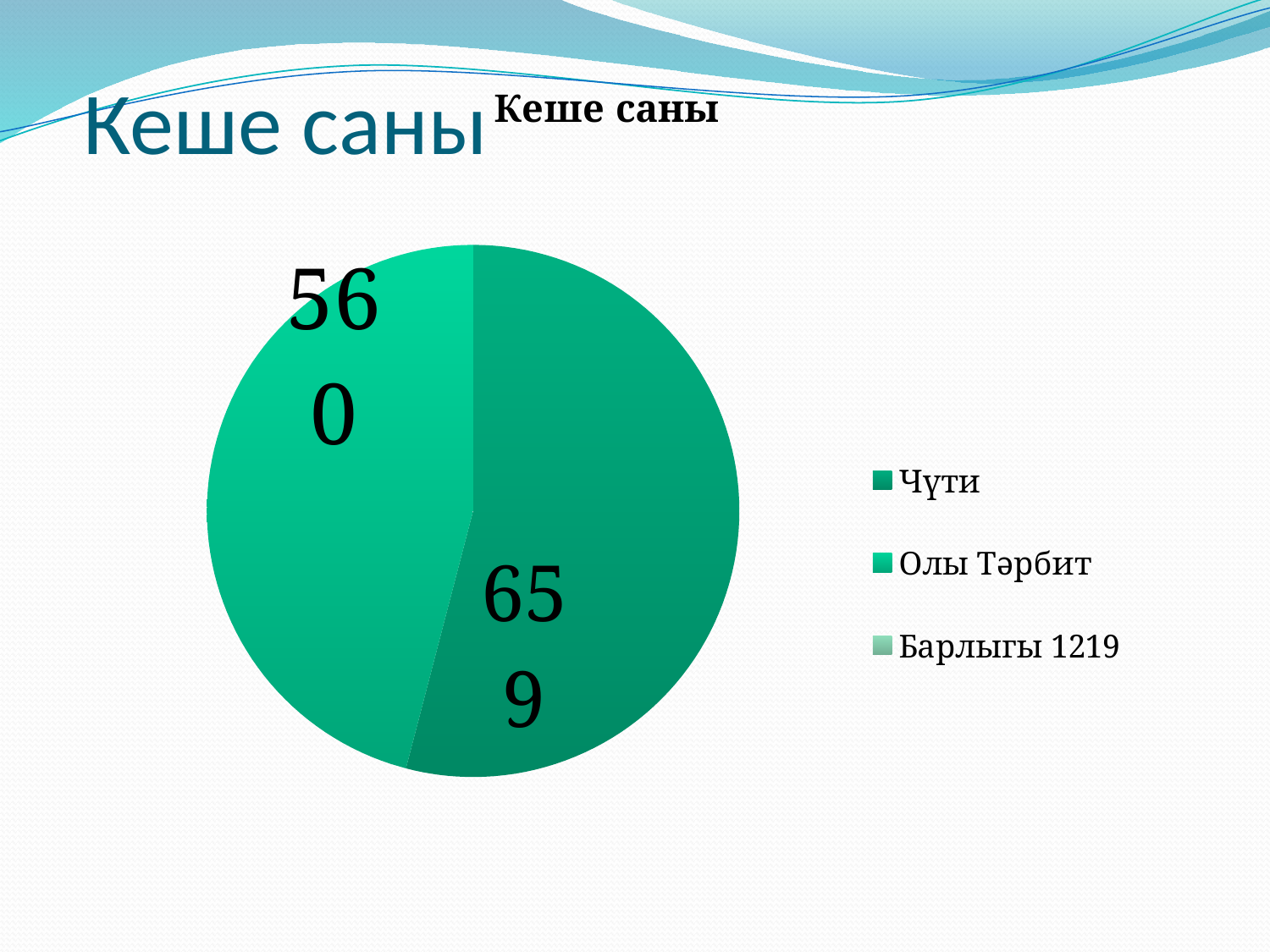
What is the value of the Чүти slice in the pie chart? 659 What is the value of the Олы Тәрбит slice in the pie chart? 560 What is the difference between the Чүти and Олы Тәрбит values? 99 Which category has the largest slice in the pie chart? Чүти What total is given in the legend entry 'Барлыгы'? 1219 Which is larger, the Чүти slice or the Олы Тәрбит slice? Чүти What type of chart is shown on the slide? Pie chart What is the title of the chart? Кеше саны How many slices with data labels are visible in the pie chart? 2 How many entries does the chart legend list? 3 Which category has the smallest visible slice in the pie chart? Олы Тәрбит Which legend entry corresponds to the darker green slice? Чүти